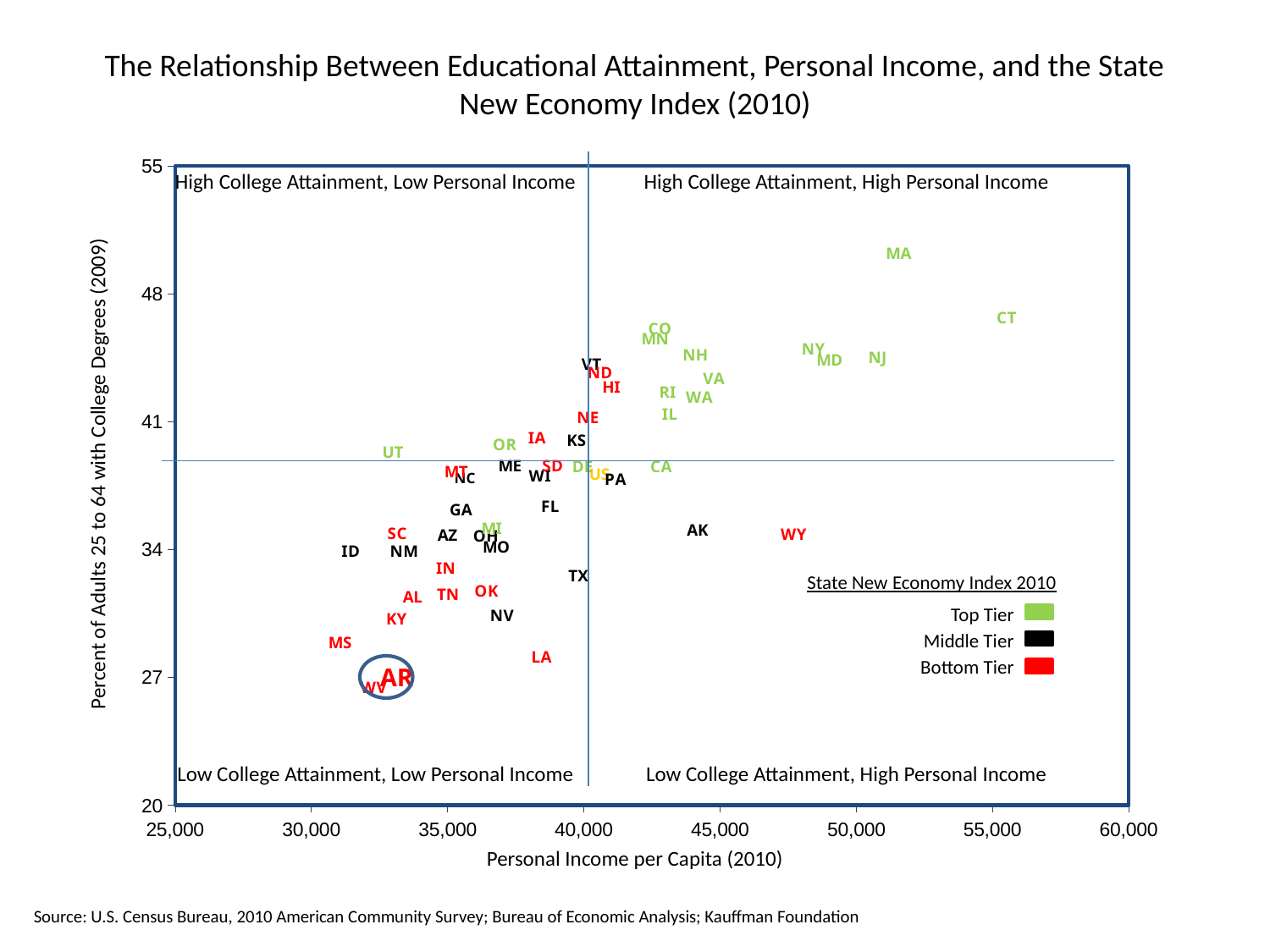
Is the personal income per capita for WY greater or less than 45,000? greater Which state has a higher percent of adults with college degrees, MA or CT? MA What kind of chart is shown on the slide? Scatter plot Which state has a higher personal income per capita, NY or MS? NY What colour represents the Bottom Tier in the legend? Red Is the personal income per capita for CT greater or less than 50,000? greater Which state has the highest personal income per capita? CT Is the personal income per capita for MS greater or less than 35,000? less Which state has the highest percent of adults 25 to 64 with college degrees? MA How many tiers does the State New Economy Index 2010 legend list? 3